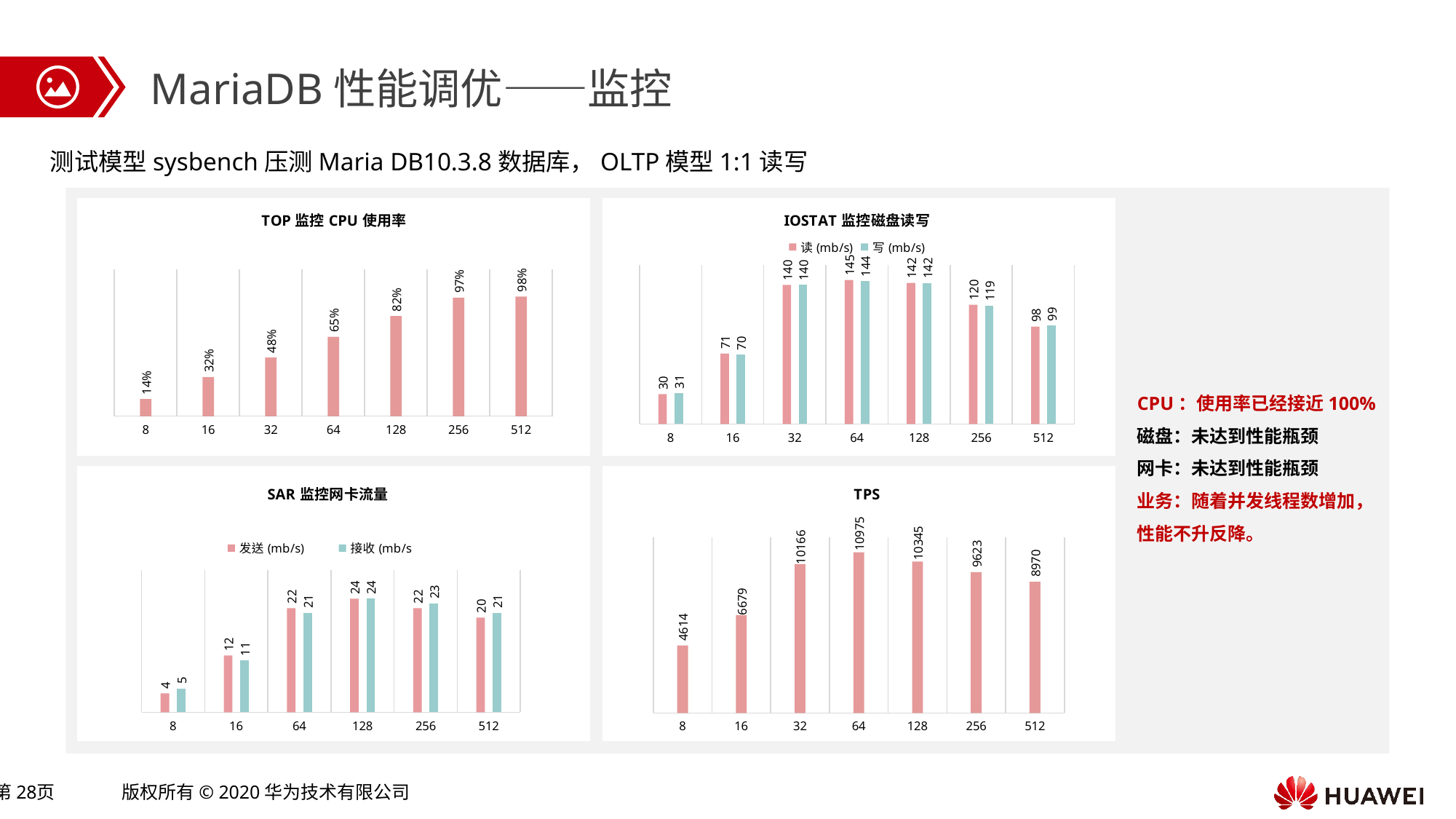
In the 'TOP 监控 CPU 使用率' chart, what is the difference between the values at 512 and 8? 84% In the 'TOP 监控 CPU 使用率' chart, what is the CPU usage at 128? 82% In the 'TPS' chart, which category has the highest TPS? 64 In the 'IOSTAT 监控磁盘读写' chart, how many series does the legend list? 2 In the 'SAR 监控网卡流量' chart, what is the 接收 (mb/s) value at 256? 23 In the 'SAR 监控网卡流量' chart, how many categories are shown on the x axis? 6 In the 'IOSTAT 监控磁盘读写' chart, what is the 写 (mb/s) value at 512? 99 In the 'TPS' chart, what is the difference between the TPS at 64 and at 8? 6361 What kind of chart is the 'TPS' chart? Bar chart In the 'TOP 监控 CPU 使用率' chart, which category has the lowest CPU usage? 8 In the 'IOSTAT 监控磁盘读写' chart, what is the 读 (mb/s) value at 64? 145 In the 'SAR 监控网卡流量' chart, which is larger at 16: 发送 (mb/s) or 接收 (mb/s)? 发送 (mb/s)